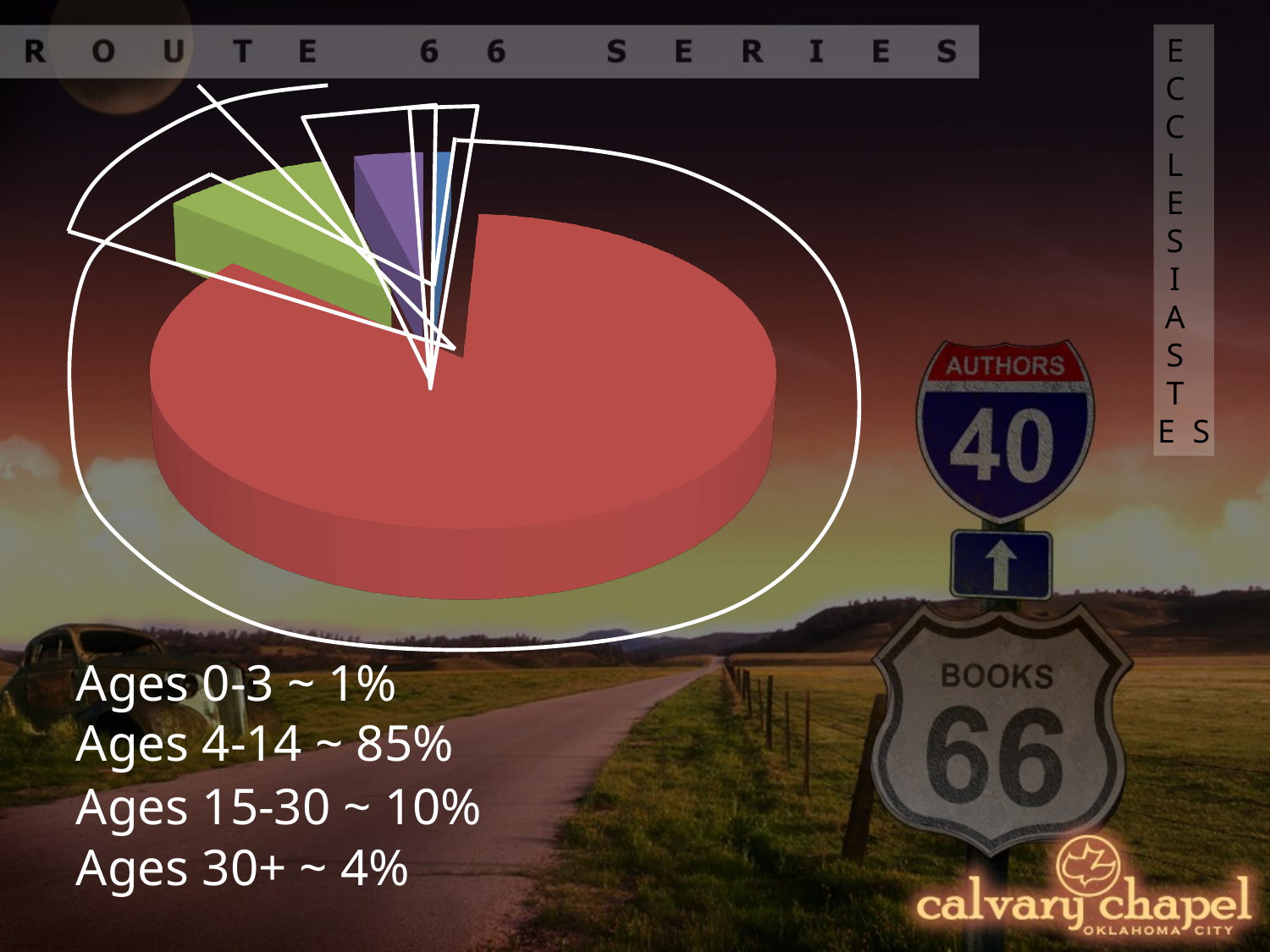
How many slices does the pie chart have? 4 Which has the larger share, Ages 0-3 or Ages 30+? Ages 30+ What kind of chart is shown on the slide? pie chart Which age group has the smallest share of the pie? Ages 0-3 Which age group has the largest share of the pie? Ages 4-14 What share is listed for Ages 15-30? 10% What share is listed for Ages 30+? 4% What share is listed for Ages 4-14? 85% What is the title text shown across the top of the slide? ROUTE 66 SERIES What share is listed for Ages 0-3? 1% Which has the larger share, Ages 15-30 or Ages 30+? Ages 15-30 What colour is the largest slice of the pie chart? red